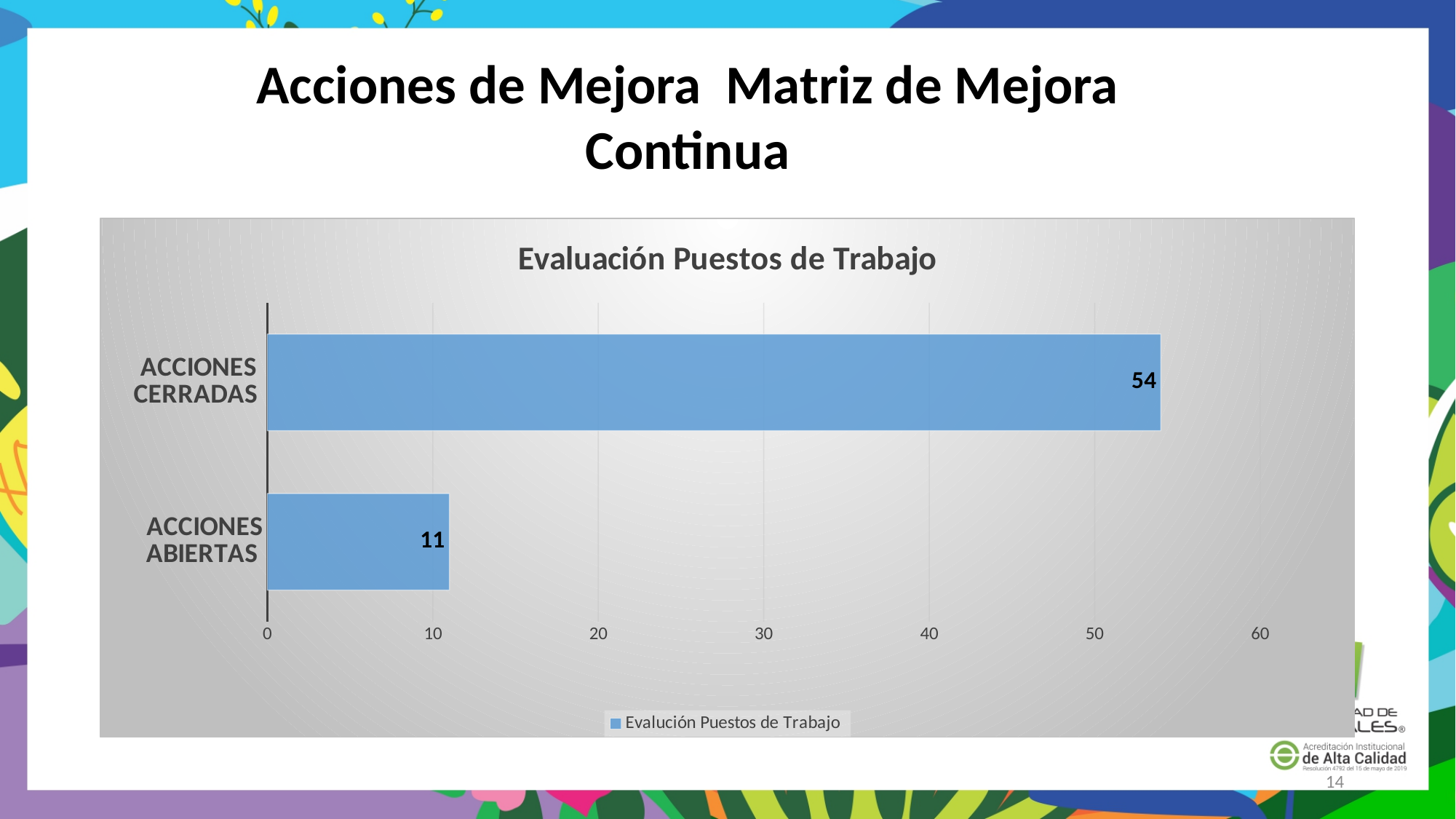
Which is larger, the value for ACCIONES ABIERTAS or the value for ACCIONES CERRADAS? ACCIONES CERRADAS How many series does the legend list? 1 Which category has the highest value? ACCIONES CERRADAS What kind of chart is shown on the slide? bar chart What is the value for ACCIONES CERRADAS? 54 What is the difference between the values for ACCIONES CERRADAS and ACCIONES ABIERTAS? 43 What is the value for ACCIONES ABIERTAS? 11 How many categories are shown in the chart? 2 Is the value for ACCIONES CERRADAS greater or less than 50? greater What is the title of the chart? Evaluación Puestos de Trabajo Is the value for ACCIONES ABIERTAS greater or less than 20? less Which category has the lowest value? ACCIONES ABIERTAS